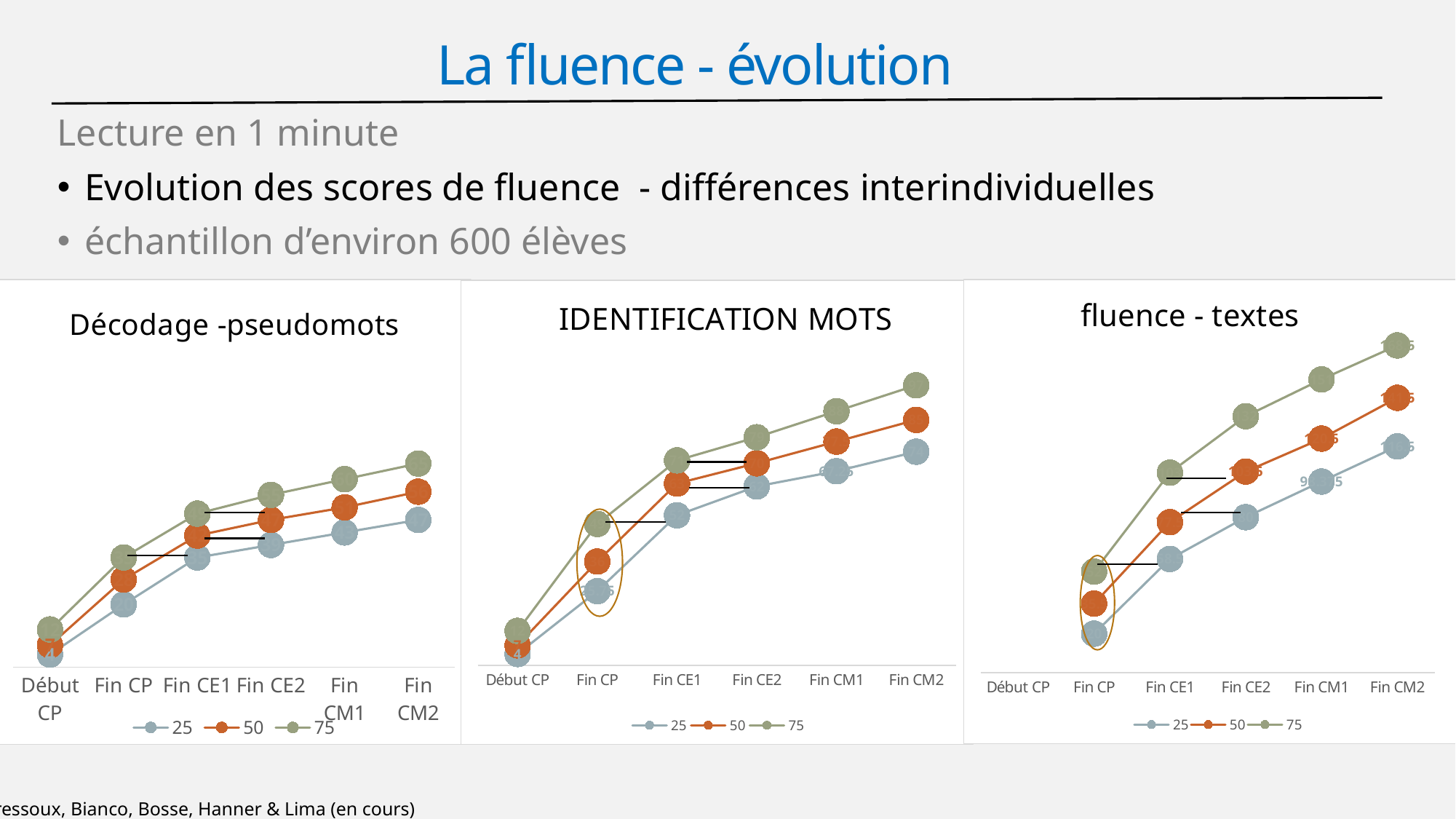
In the 'fluence - textes' chart, which series has the highest value at Fin CM2? 75 In the 'fluence - textes' chart, do the values of the 25 series rise or fall along the x axis? rise In the 'IDENTIFICATION MOTS' chart, at Fin CP, which is larger: the value for the 50 series or the 25 series? 50 In the 'Décodage -pseudomots' chart, do the values of the 75 series rise or fall from Début CP to Fin CM2? rise In the 'Décodage -pseudomots' chart, at Fin CE1, which is larger: the value for the 75 series or the 25 series? 75 What is the first category on the x axis of the 'Décodage -pseudomots' chart? Début CP How many categories are shown on the x axis of the 'IDENTIFICATION MOTS' chart? 6 What are the legend entries of the 'IDENTIFICATION MOTS' chart? 25, 50, 75 In the 'IDENTIFICATION MOTS' chart, which series has the lowest value at Fin CM2? 25 What kind of chart is the 'Décodage -pseudomots' chart? line chart How many series does the legend of the 'fluence - textes' chart list? 3 What is the title of the rightmost chart on the slide? fluence - textes